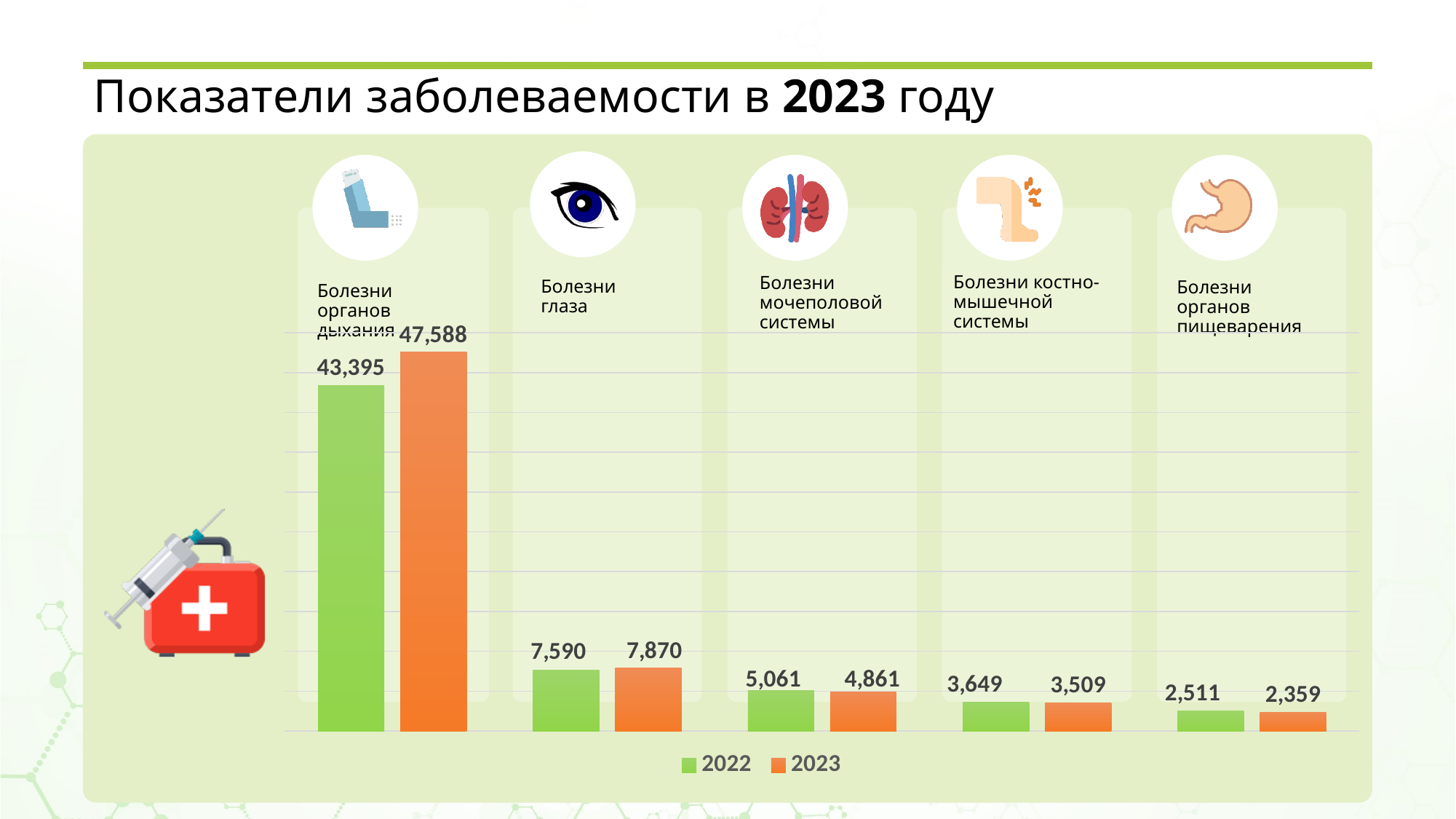
What is the 2022 value for Болезни органов пищеварения? 2,511 Which is larger for Болезни глаза: the 2022 value or the 2023 value? 2023 What is the 2023 value for Болезни мочеполовой системы? 4,861 How many series does the legend list? 2 What type of chart is shown on the slide? Bar chart Which category has the highest 2023 value? Болезни органов дыхания Which category has the lowest 2022 value? Болезни органов пищеварения What is the difference between the 2023 and 2022 values for Болезни органов дыхания? 4,193 What is the difference between the 2022 and 2023 values for Болезни костно-мышечной системы? 140 How many disease categories are shown in the chart? 5 What is the 2023 value for Болезни органов дыхания? 47,588 What is the 2022 value for Болезни глаза? 7,590